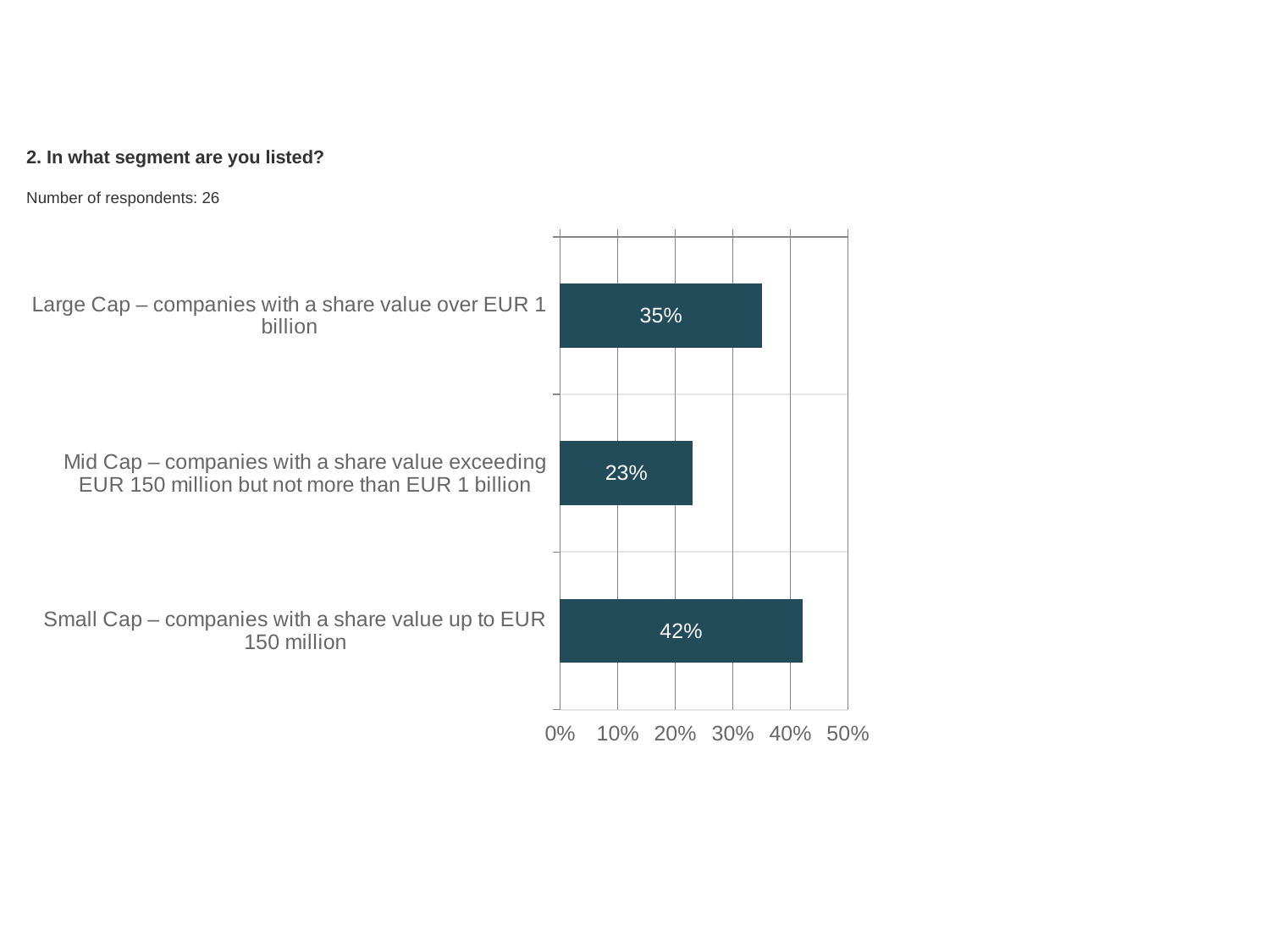
What percentage of respondents are listed in the Large Cap segment? 35% What kind of chart is shown on the slide? Bar chart What is the difference in percentage points between the Small Cap and Mid Cap segments? 19 percentage points Which segment has the highest share of respondents? Small Cap How many segments are shown in the chart? 3 What percentage of respondents are listed in the Small Cap segment? 42% What percentage of respondents are listed in the Mid Cap segment? 23% What is the difference in percentage points between the Large Cap and Mid Cap segments? 12 percentage points Is the value for Mid Cap greater or less than 30%? less Which segment has the lowest share of respondents? Mid Cap Which is larger, the share for Large Cap or the share for Small Cap? Small Cap How many respondents answered the question shown on the slide? 26